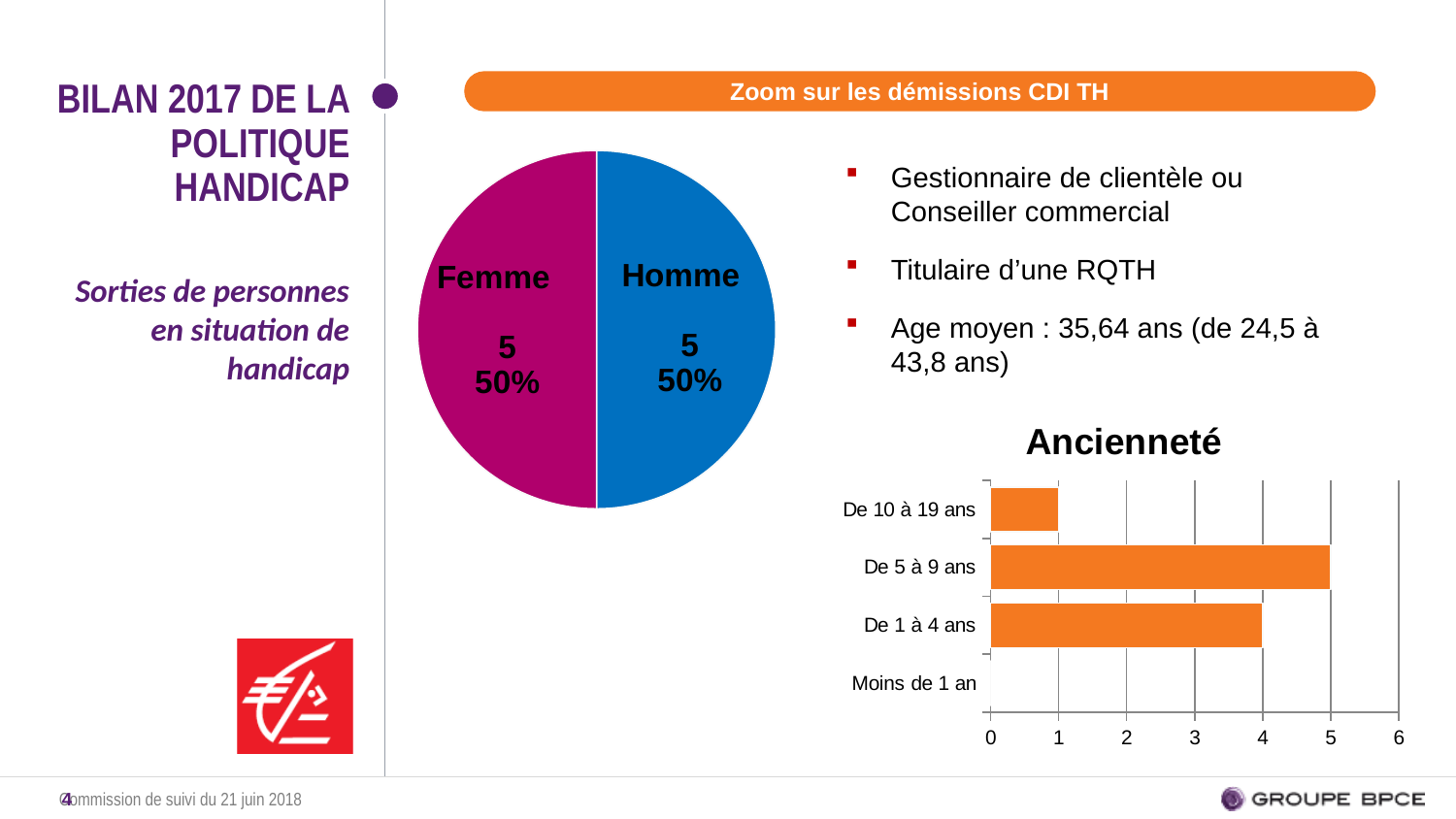
In the Ancienneté chart, how many categories are listed on the axis? 4 In the pie chart, which is larger, Femme or Homme? They are equal In the pie chart, how many slices are there? 2 In the pie chart, what share does Homme represent? 50% In the pie chart, what value is shown for Femme? 5 What kind of chart is the Ancienneté chart? bar chart In the Ancienneté chart, what is the difference between De 5 à 9 ans and De 10 à 19 ans? 4 In the Ancienneté chart, which category has the highest value? De 5 à 9 ans In the Ancienneté chart, what is the value for De 1 à 4 ans? 4 What kind of chart is the chart showing Femme and Homme? pie chart In the Ancienneté chart, what is the value for De 5 à 9 ans? 5 In the Ancienneté chart, what is the value for De 10 à 19 ans? 1